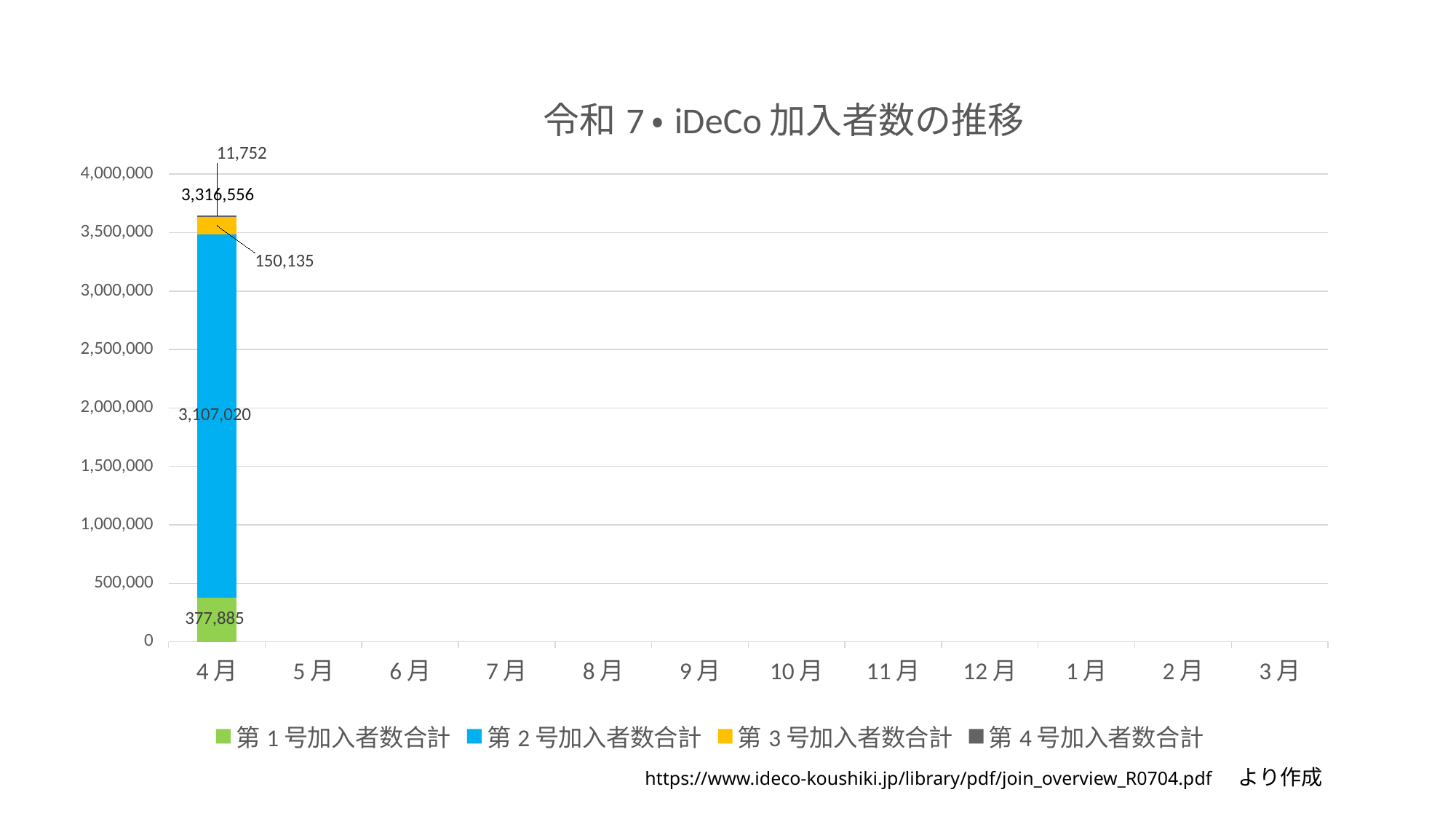
What kind of chart is shown on the slide? Stacked bar chart What is the value of 第３号加入者数合計 for 4月? 150,135 How many month categories are shown on the x axis? 12 In 4月, which is larger: 第１号加入者数合計 or 第３号加入者数合計? 第１号加入者数合計 What is the value of 第２号加入者数合計 for 4月? 3,107,020 How many series does the legend list? 4 What is the difference between 第１号加入者数合計 and 第３号加入者数合計 in 4月? 227,750 What is the value of 第１号加入者数合計 for 4月? 377,885 What is the title of the chart? 令和７・iDeCo 加入者数の推移 Which series has the smallest value in 4月? 第４号加入者数合計 What is the value of 第４号加入者数合計 for 4月? 11,752 Which series has the largest value in 4月? 第２号加入者数合計